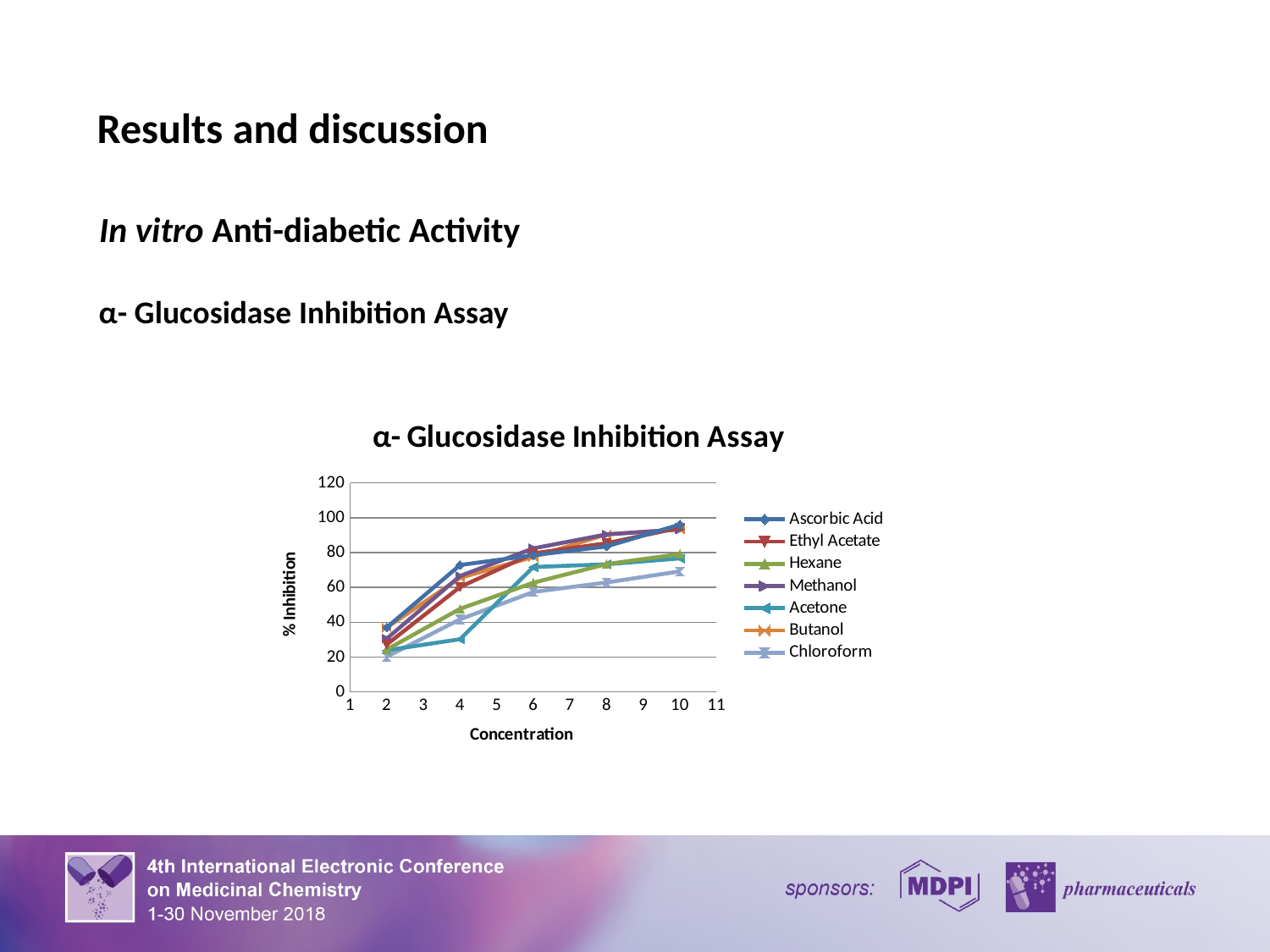
How many data points are plotted for each series? 5 At concentration 4, which is larger: Ascorbic Acid or Acetone? Ascorbic Acid Which series has the lowest value at concentration 4? Acetone How many series does the legend list? 7 What kind of chart is shown on the slide? line chart Do the values for Ascorbic Acid rise or fall as concentration increases? rise Is the value for Acetone at concentration 4 greater or less than 40? less What is the label of the y axis? % Inhibition What is the title of the chart? α- Glucosidase Inhibition Assay Is the value for Chloroform at concentration 10 greater or less than 80? less Is the value for Ascorbic Acid at concentration 10 greater or less than 80? greater